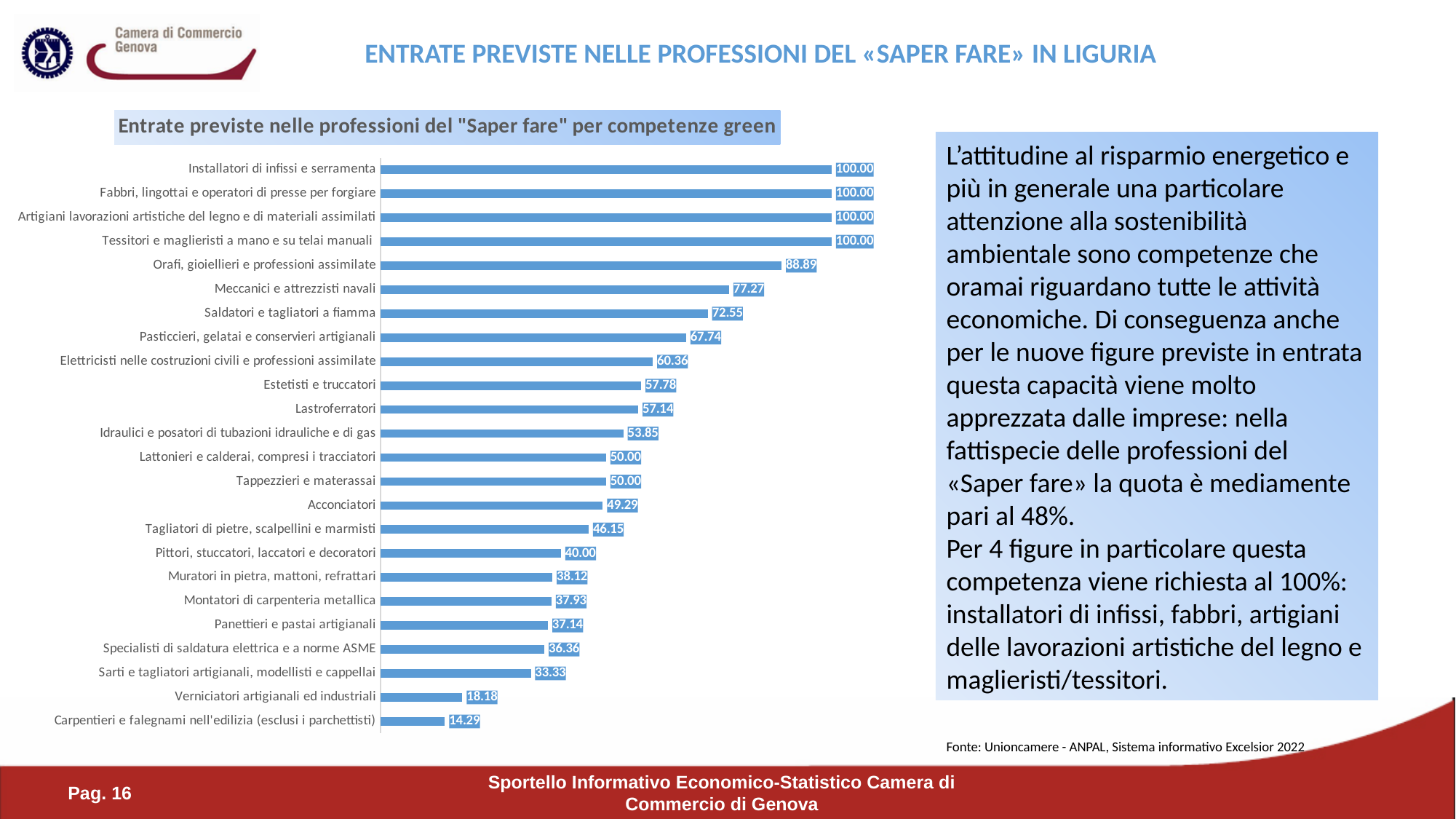
What is the value for Meccanici e attrezzisti navali? 77.27 What is the difference between the values for Orafi, gioiellieri e professioni assimilate and Carpentieri e falegnami nell'edilizia (esclusi i parchettisti)? 74.60 What kind of chart is shown on the slide? Bar chart How many categories have a value of 100.00? 4 Which category has the lowest value? Carpentieri e falegnami nell'edilizia (esclusi i parchettisti) What is the title of the chart? Entrate previste nelle professioni del "Saper fare" per competenze green What is the difference between the values for Saldatori e tagliatori a fiamma and Pasticcieri, gelatai e conservieri artigianali? 4.81 What is the value for Orafi, gioiellieri e professioni assimilate? 88.89 Which is larger, the value for Acconciatori or the value for Tagliatori di pietre, scalpellini e marmisti? Acconciatori What is the value for Lastroferratori? 57.14 What is the value for Verniciatori artigianali ed industriali? 18.18 How many categories are shown in the chart? 24